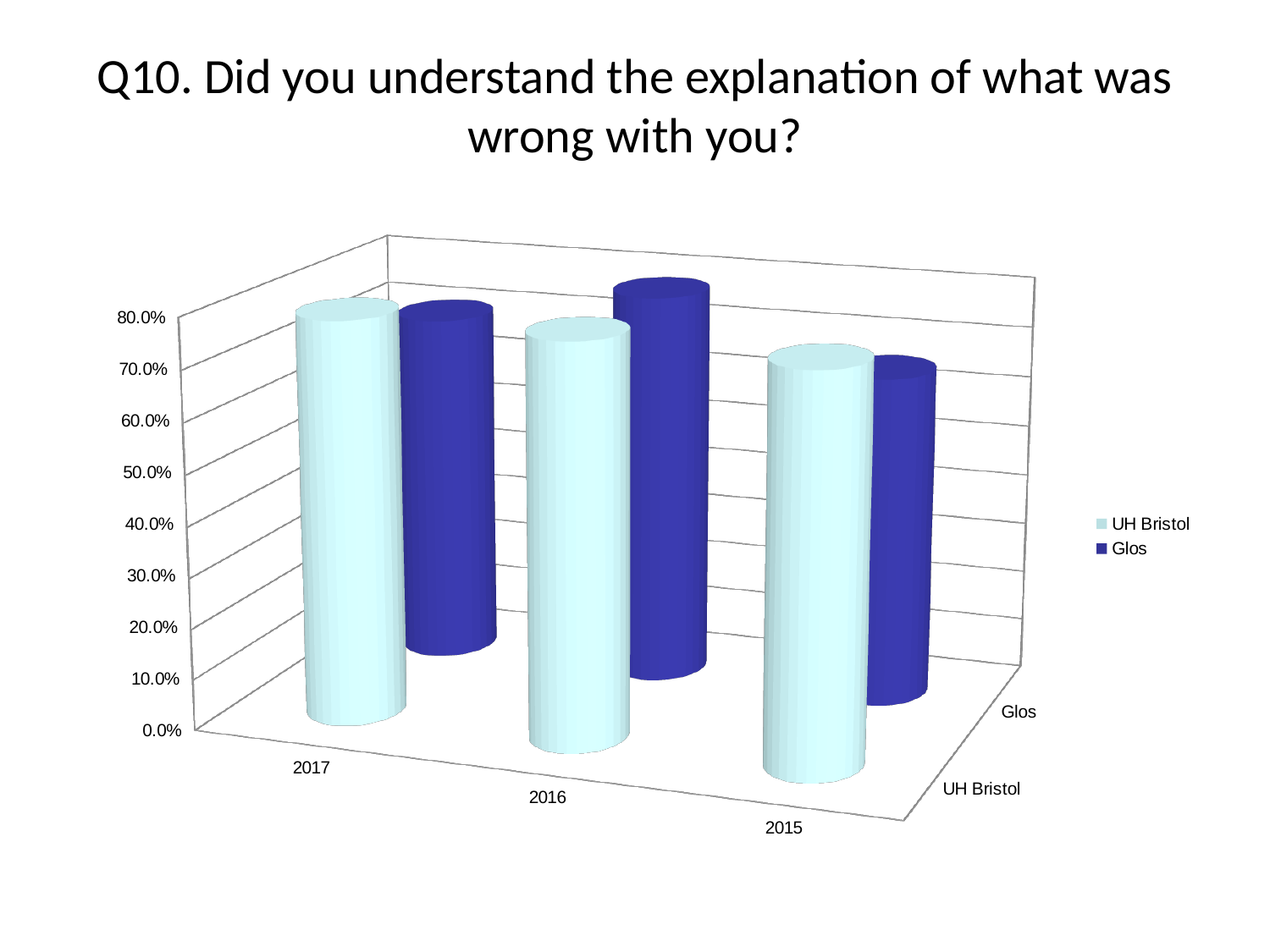
How many series does the chart's legend list? 2 Is the value for Glos in 2015 greater or less than 40.0%? greater What is the title of the chart on the slide? Q10. Did you understand the explanation of what was wrong with you? Is the value for Glos in 2016 greater or less than 50.0%? greater How many year categories are shown along the x axis of the chart? 3 Is the value for UH Bristol in 2017 greater or less than 50.0%? greater What kind of chart is shown on the slide? bar chart Which two series are listed in the chart's legend? UH Bristol and Glos